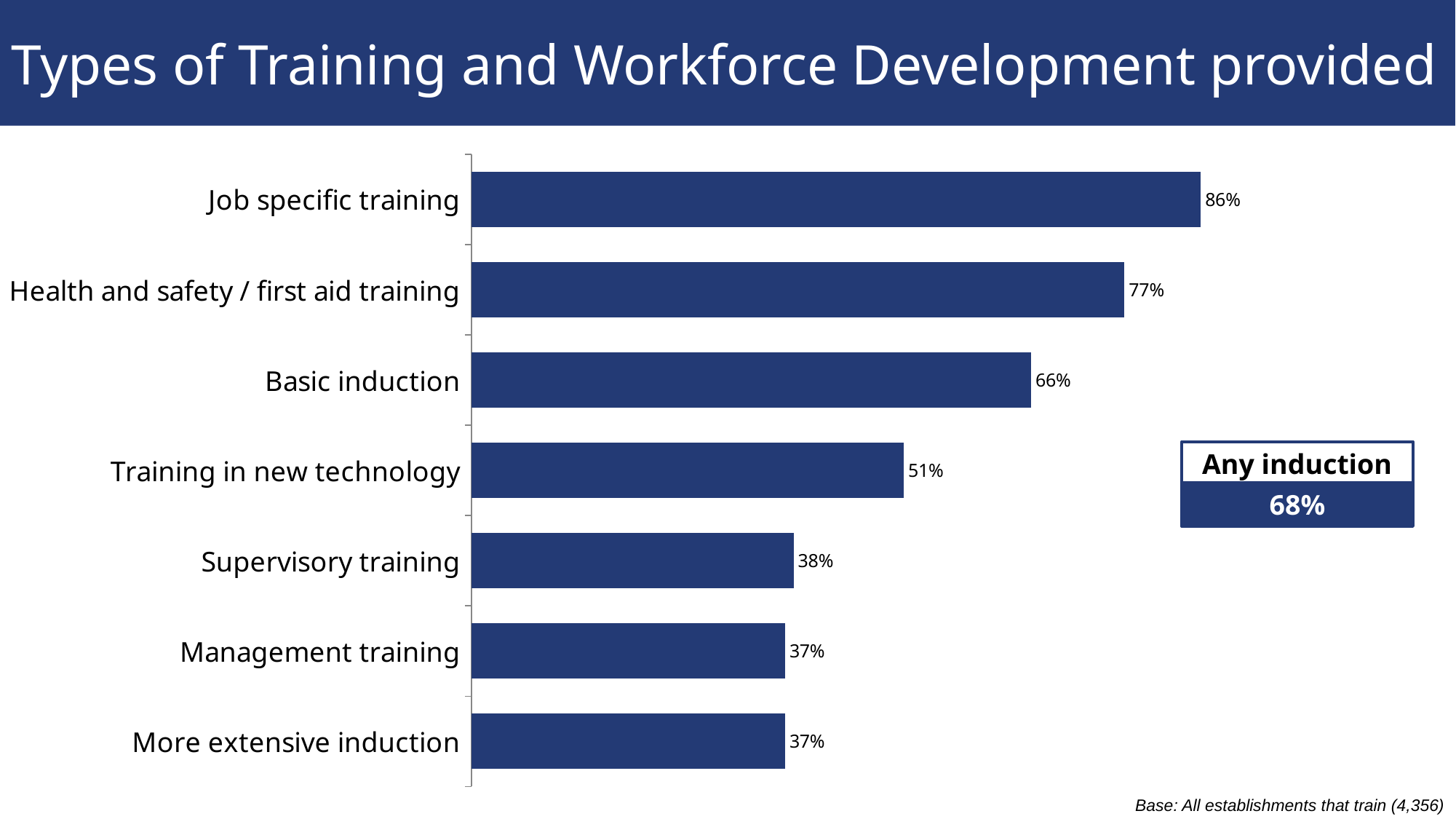
How many types of training are shown in the chart? 7 What kind of chart is shown on the slide? Bar chart Which is larger, Basic induction or Training in new technology? Basic induction Which type of training has the highest value? Job specific training What is the difference between Job specific training and Health and safety / first aid training? 9% What percentage is shown in the 'Any induction' box? 68% What is the title of the slide? Types of Training and Workforce Development provided What is the value for Management training? 37% What is the value for Supervisory training? 38% What is the difference between Basic induction and More extensive induction? 29% What is the value for Training in new technology? 51% What percentage of establishments provide job specific training? 86%